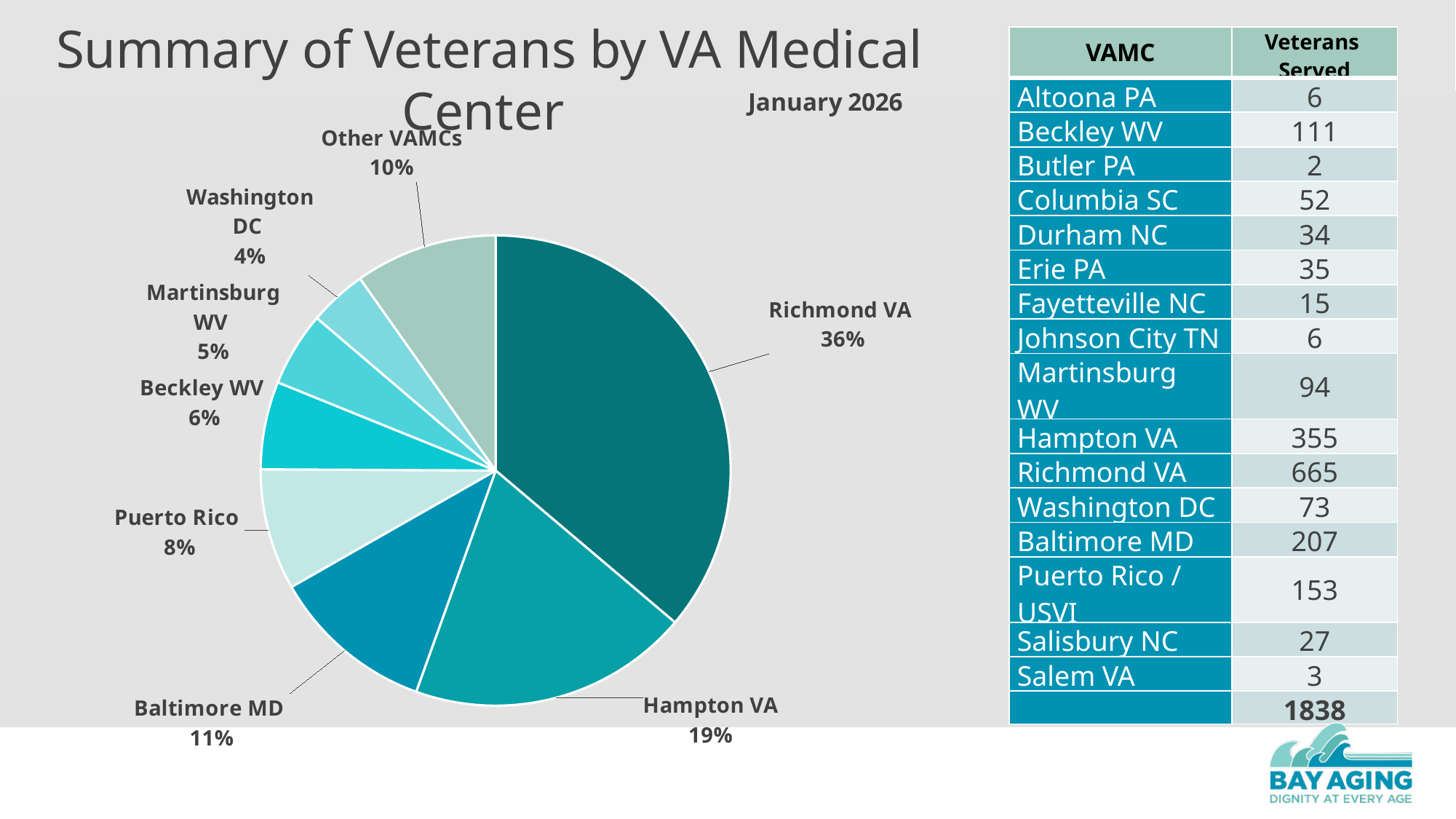
What percentage is shown for Hampton VA in the pie chart? 19% What percentage is shown for Other VAMCs in the pie chart? 10% What percentage is shown for Baltimore MD in the pie chart? 11% Which has a larger share in the pie chart, Beckley WV or Martinsburg WV? Beckley WV What kind of chart is shown on the slide? Pie chart How many slices does the pie chart have? 8 What share of the pie does Richmond VA represent? 36% What is the title of the chart? January 2026 Which slice of the pie chart is the largest? Richmond VA What percentage is shown for Puerto Rico in the pie chart? 8% Which labelled slice of the pie chart is the smallest? Washington DC What is the difference in percentage points between Richmond VA and Hampton VA in the pie chart? 17